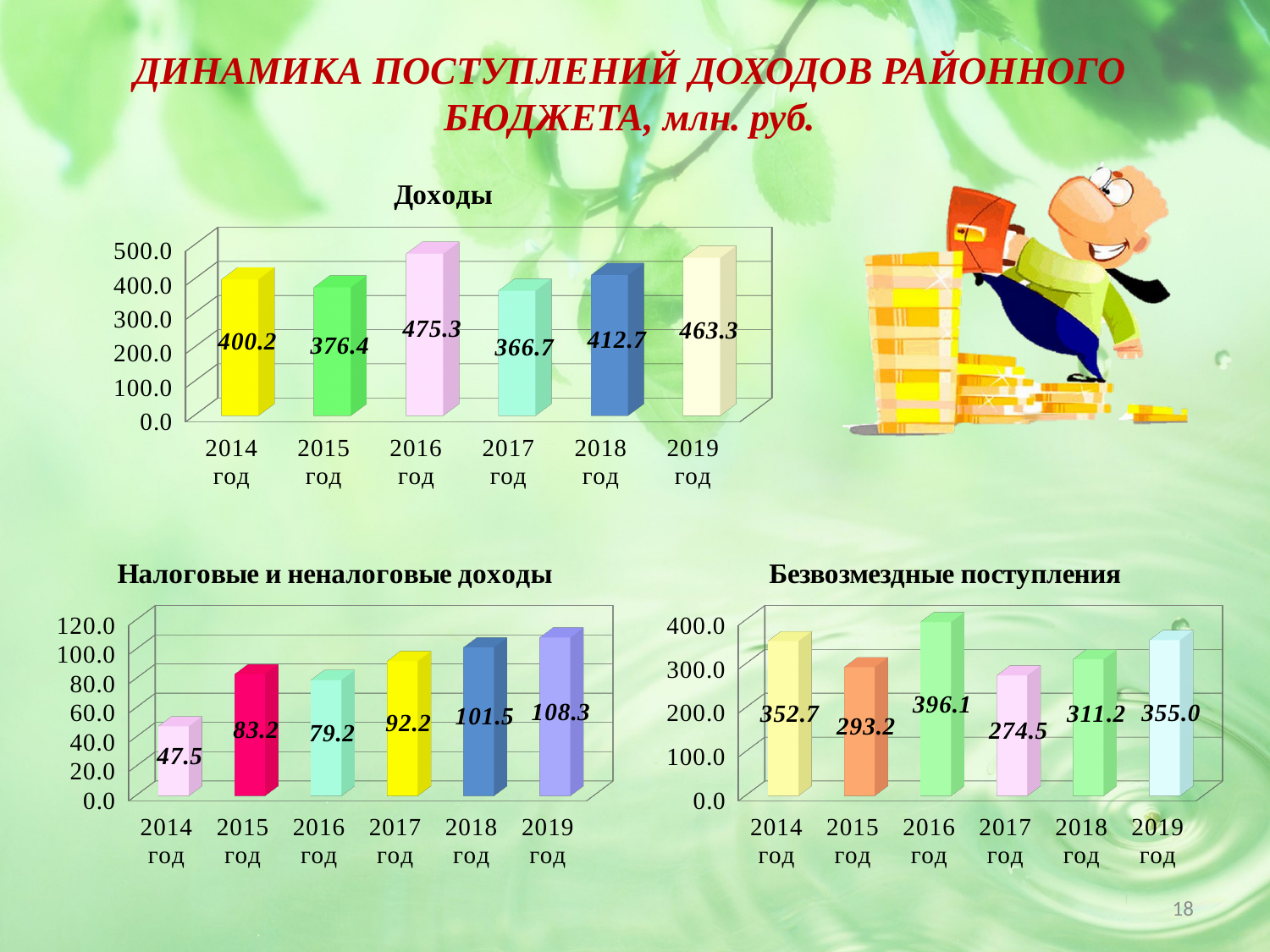
In the "Налоговые и неналоговые доходы" chart, which is larger, the value for 2015 год or 2016 год? 2015 год In the "Налоговые и неналоговые доходы" chart, what is the value for 2014 год? 47.5 What kind of chart is the "Безвозмездные поступления" chart? Bar chart In the "Безвозмездные поступления" chart, which year has the highest value? 2016 год In the "Налоговые и неналоговые доходы" chart, which year has the highest value? 2019 год In the "Безвозмездные поступления" chart, what is the value for 2017 год? 274.5 How many years are shown in the "Доходы" chart? 6 In the "Доходы" chart, which year has the lowest value? 2017 год In the "Безвозмездные поступления" chart, what is the difference between the values for 2016 год and 2015 год? 102.9 In the "Налоговые и неналоговые доходы" chart, is the value for 2018 год greater or less than 100.0? greater In the "Доходы" chart, what is the difference between the values for 2019 год and 2018 год? 50.6 In the "Доходы" chart, what is the value for 2016 год? 475.3